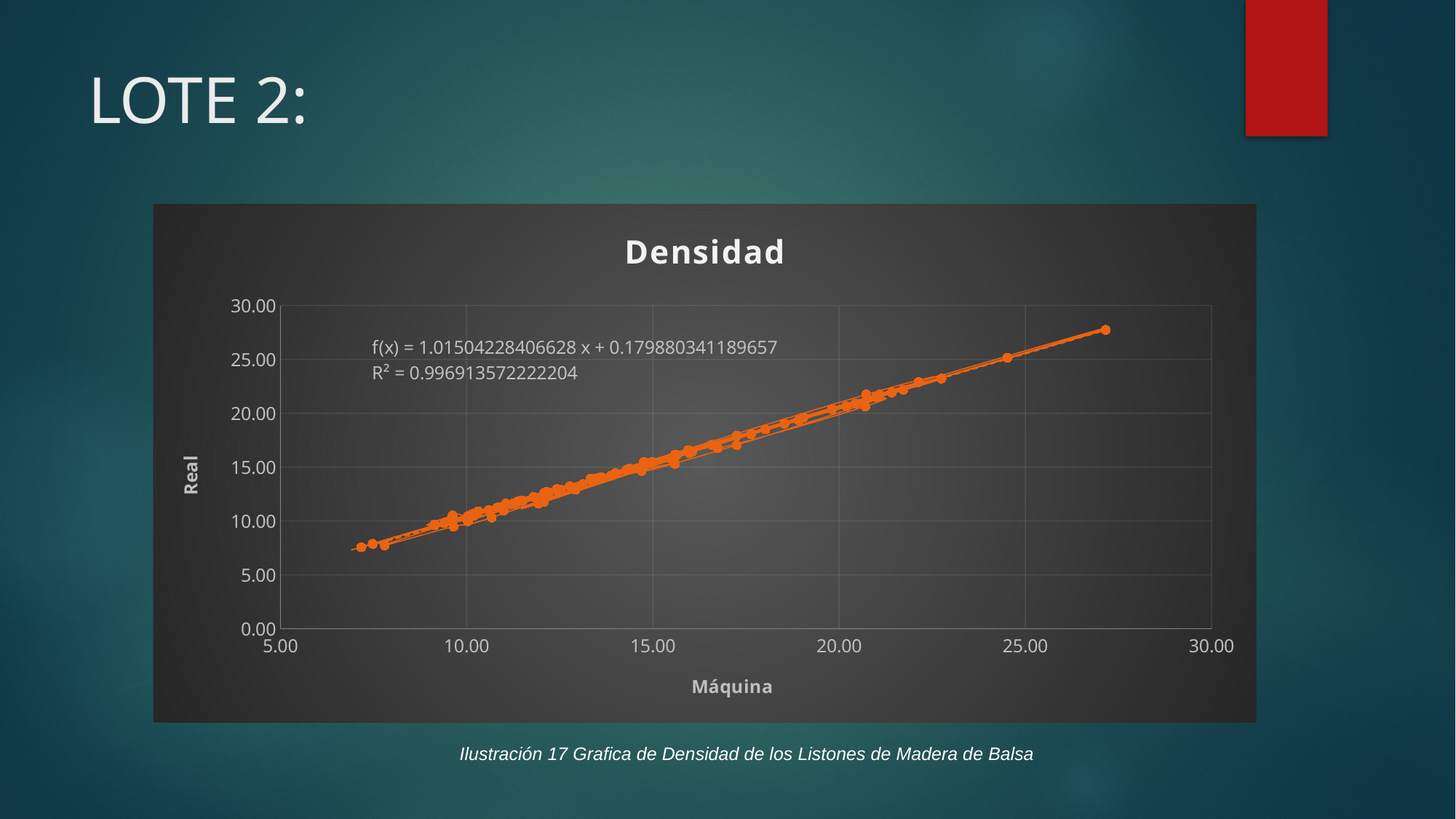
What is the label of the x axis? Máquina What is the slope of the trendline shown in the equation on the chart? 1.01504228406628 What is the trendline equation printed on the chart? f(x) = 1.01504228406628 x + 0.179880341189657 What is the title of the chart? Densidad What is the maximum value shown on the y axis? 30.00 Is the Máquina value of the rightmost data point greater or less than 25.00? greater Is the Real value of the leftmost data point greater or less than 10.00? less What is the R² value printed on the chart? R² = 0.996913572222204 Is the Real value of the rightmost data point greater or less than 25.00? greater What kind of chart is shown on the slide? scatter chart What is the intercept of the trendline shown in the equation on the chart? 0.179880341189657 Do the Real values rise or fall as the Máquina values increase along the x axis? rise